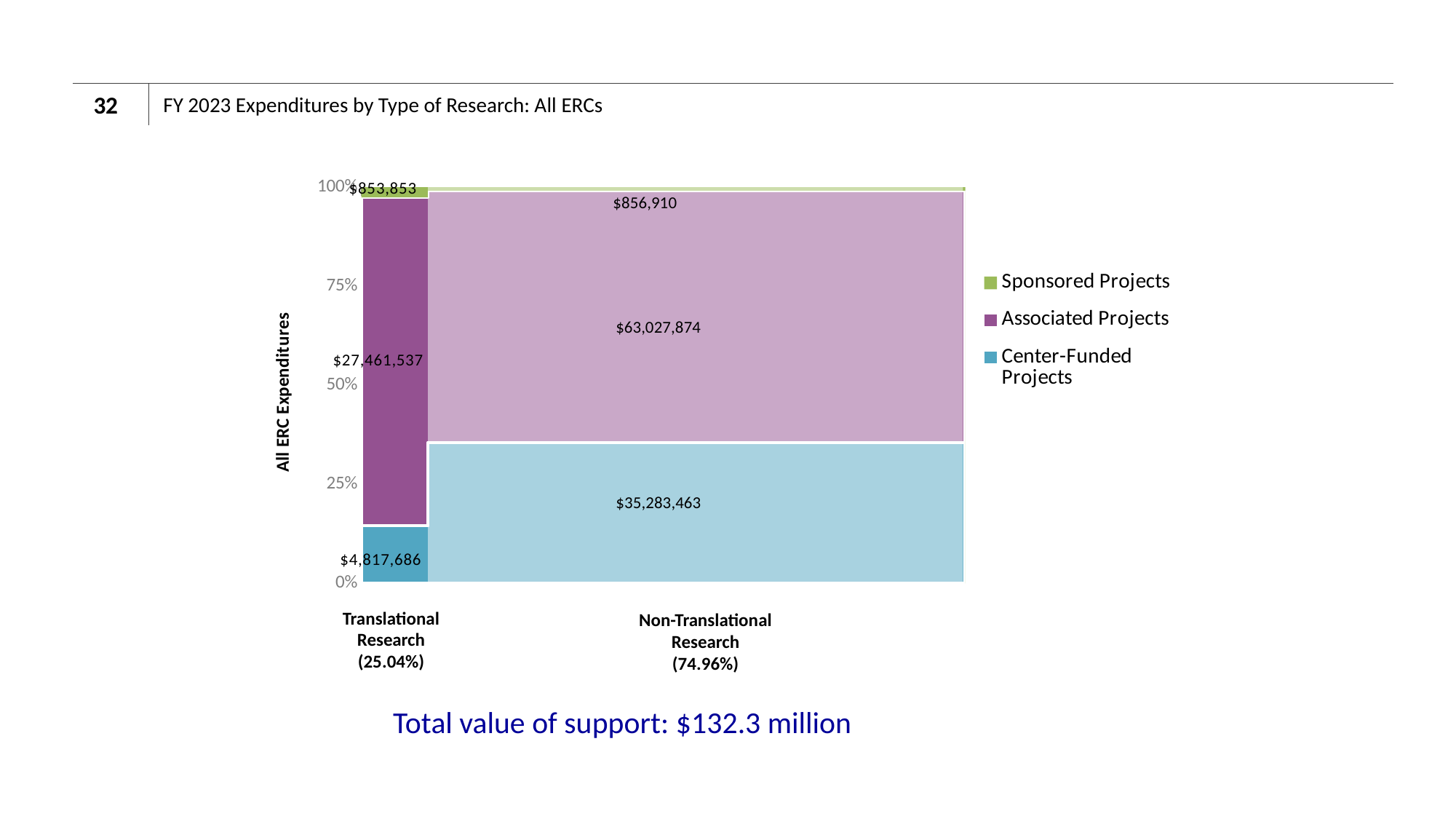
What is the value for Sponsored Projects in the Non-Translational Research bar? $856,910 Which is larger: Center-Funded Projects for Translational Research or Sponsored Projects for Translational Research? Center-Funded Projects for Translational Research Which series has the smallest value within the Translational Research bar? Sponsored Projects What is the value for Associated Projects in the Translational Research bar? $27,461,537 Which series has the largest value within the Non-Translational Research bar? Associated Projects How many series does the legend list? 3 What is the value for Center-Funded Projects in the Non-Translational Research bar? $35,283,463 What is the value for Center-Funded Projects in the Translational Research bar? $4,817,686 How many research categories are shown on the x axis? 2 What percentage share of expenditures is shown for Translational Research on the x-axis label? 25.04% What is the difference between the Associated Projects values for Non-Translational Research and Translational Research? $35,566,337 What is the total of the Non-Translational Research bar? $99,168,247